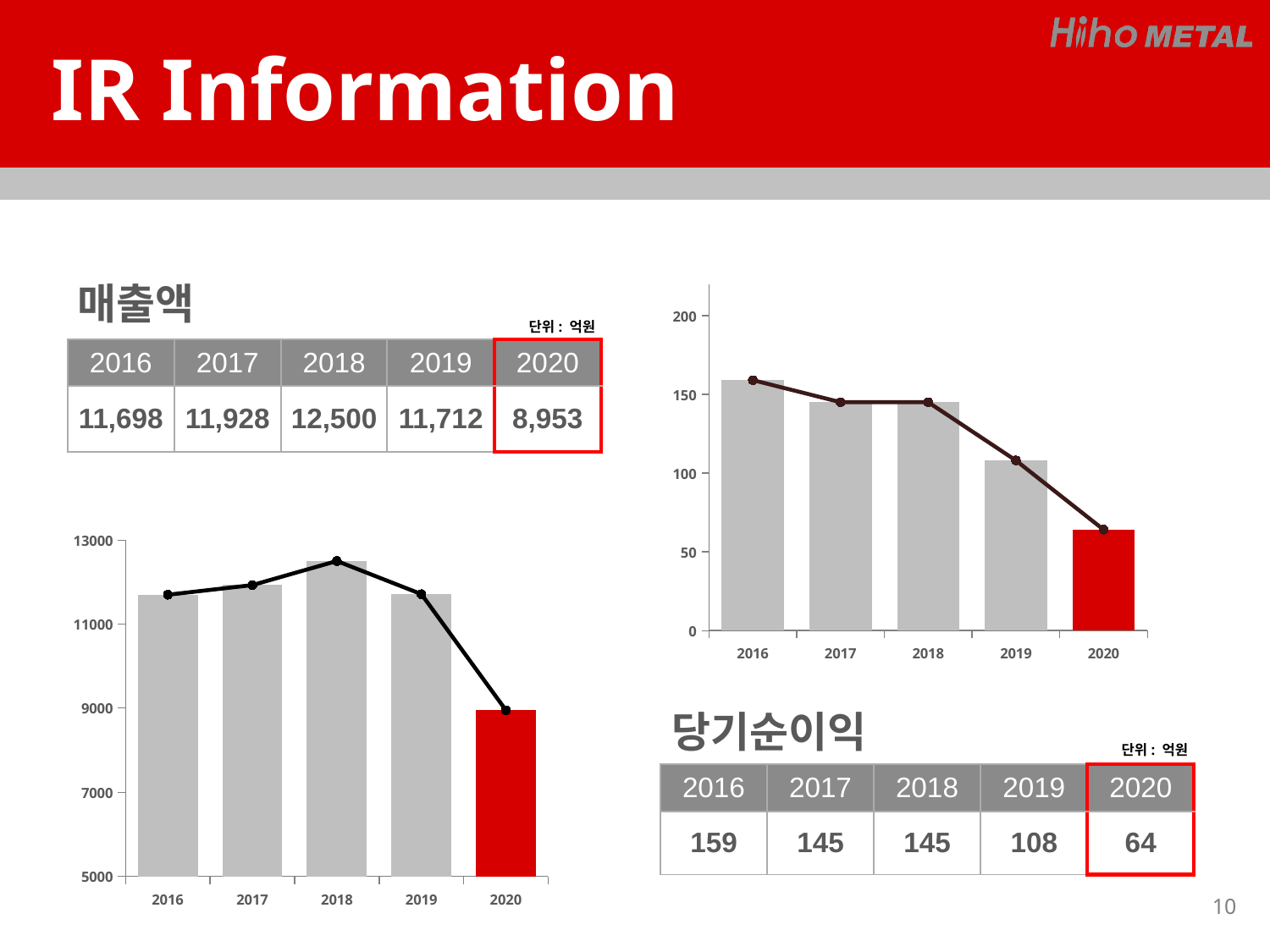
In the 당기순이익 chart on the right, is the value for 2016 greater or less than 150? greater In the 매출액 chart on the left, is the value for 2020 greater or less than 9000? less In the 매출액 chart on the left, which year has the lowest value? 2020 In the 당기순이익 chart on the right, which year has the highest value? 2016 In the 당기순이익 chart on the right, what is the value for 2019? 108 How many years are plotted in the 매출액 chart on the left? 5 In the 당기순이익 chart on the right, do the values rise or fall from 2018 to 2020? fall In the 매출액 chart on the left, which year has the highest value? 2018 In the 매출액 chart on the left, what is the value for 2018? 12,500 In the 당기순이익 chart on the right, which bar is coloured red? 2020 In the 당기순이익 chart on the right, what is the difference between the 2016 and 2020 values? 95 In the 매출액 chart on the left, what is the difference between the 2018 and 2020 values? 3,547